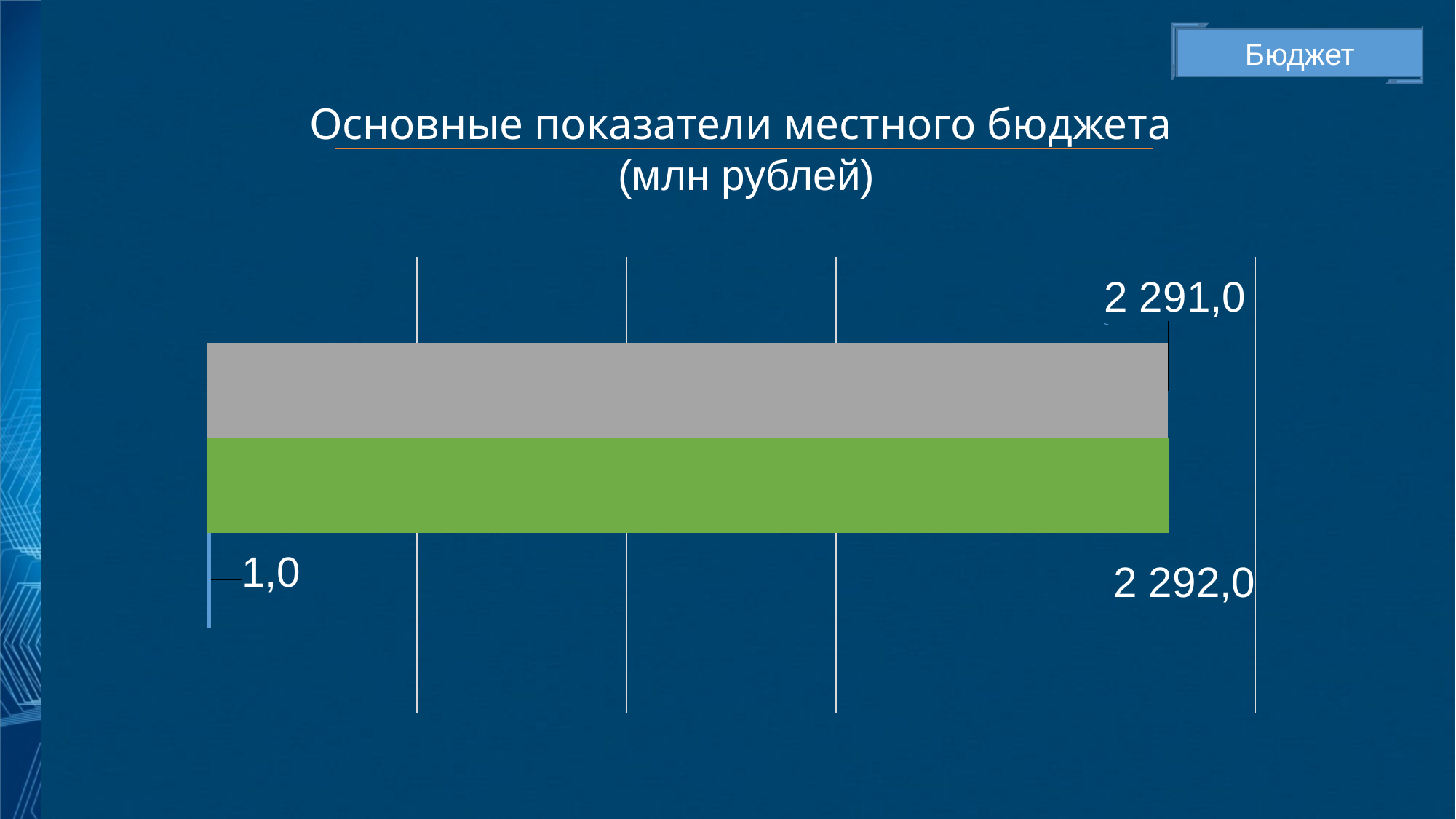
What value is labelled on the green bar? 2 292,0 What is the title of the chart? Основные показатели местного бюджета (млн рублей) What value is labelled on the small blue bar at the bottom? 1,0 What is the difference between the green bar's value (2 292,0) and the gray bar's value (2 291,0)? 1,0 What unit is stated in the chart title? млн рублей What is the smallest value shown in the chart? 1,0 What is the largest value shown in the chart? 2 292,0 Which bar has the larger labelled value, the gray bar or the green bar? the green bar What value is labelled on the gray bar? 2 291,0 What kind of chart is shown on the slide? bar chart How many bars are plotted in the chart? 3